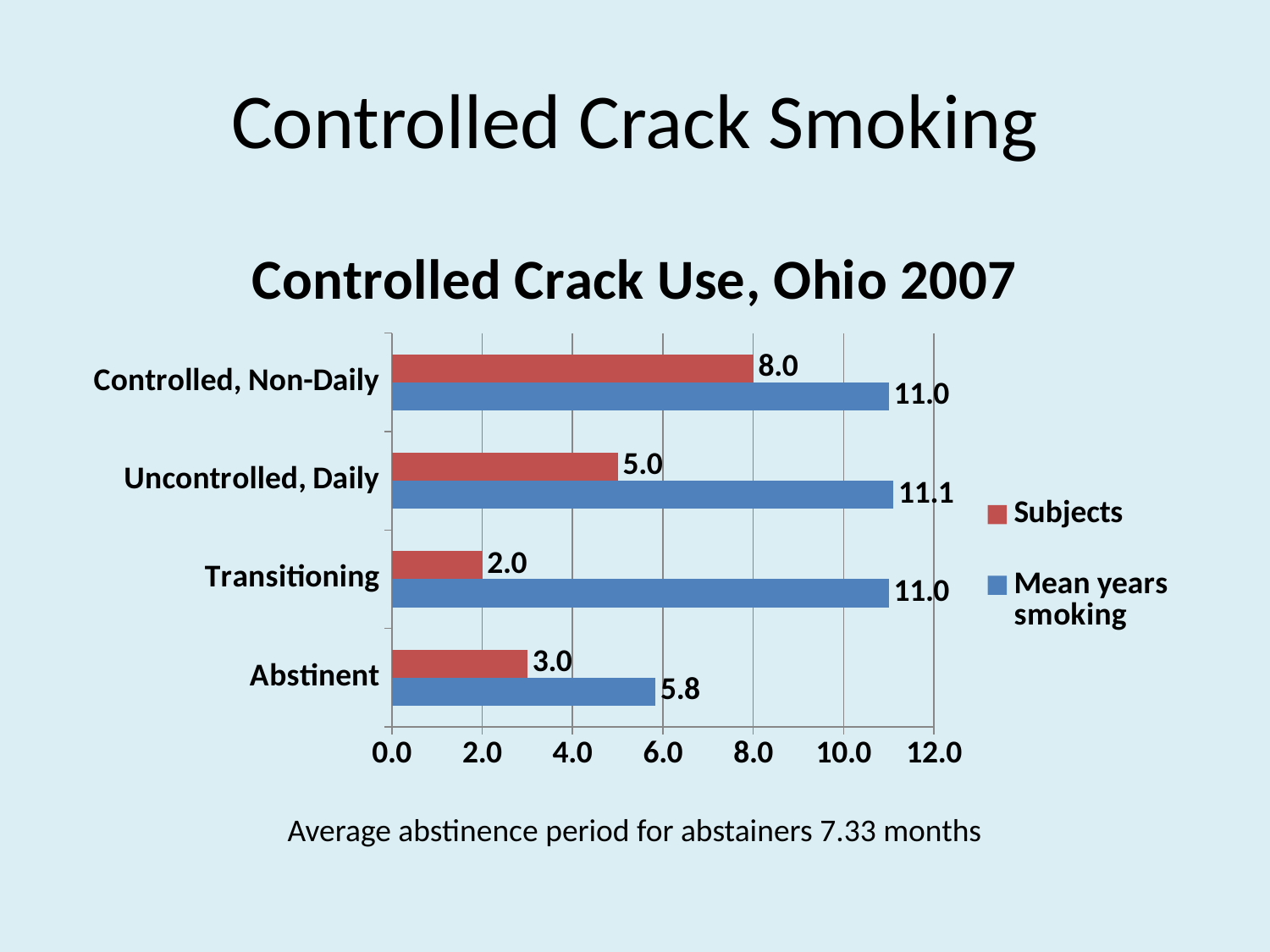
Which category has the lowest number of Subjects? Transitioning Which is larger: the number of Subjects for Abstinent or for Transitioning? Abstinent How many categories are shown on the chart? 4 How many series does the legend list? 2 What is the Mean years smoking value for the Uncontrolled, Daily category? 11.1 What is the number of Subjects for the Controlled, Non-Daily category? 8.0 What is the Mean years smoking value for the Abstinent category? 5.8 What is the difference in Mean years smoking between Transitioning and Abstinent? 5.2 Which category has the highest number of Subjects? Controlled, Non-Daily Which category has the lowest Mean years smoking? Abstinent What is the difference in Subjects between Controlled, Non-Daily and Uncontrolled, Daily? 3.0 What type of chart is shown on the slide? Bar chart